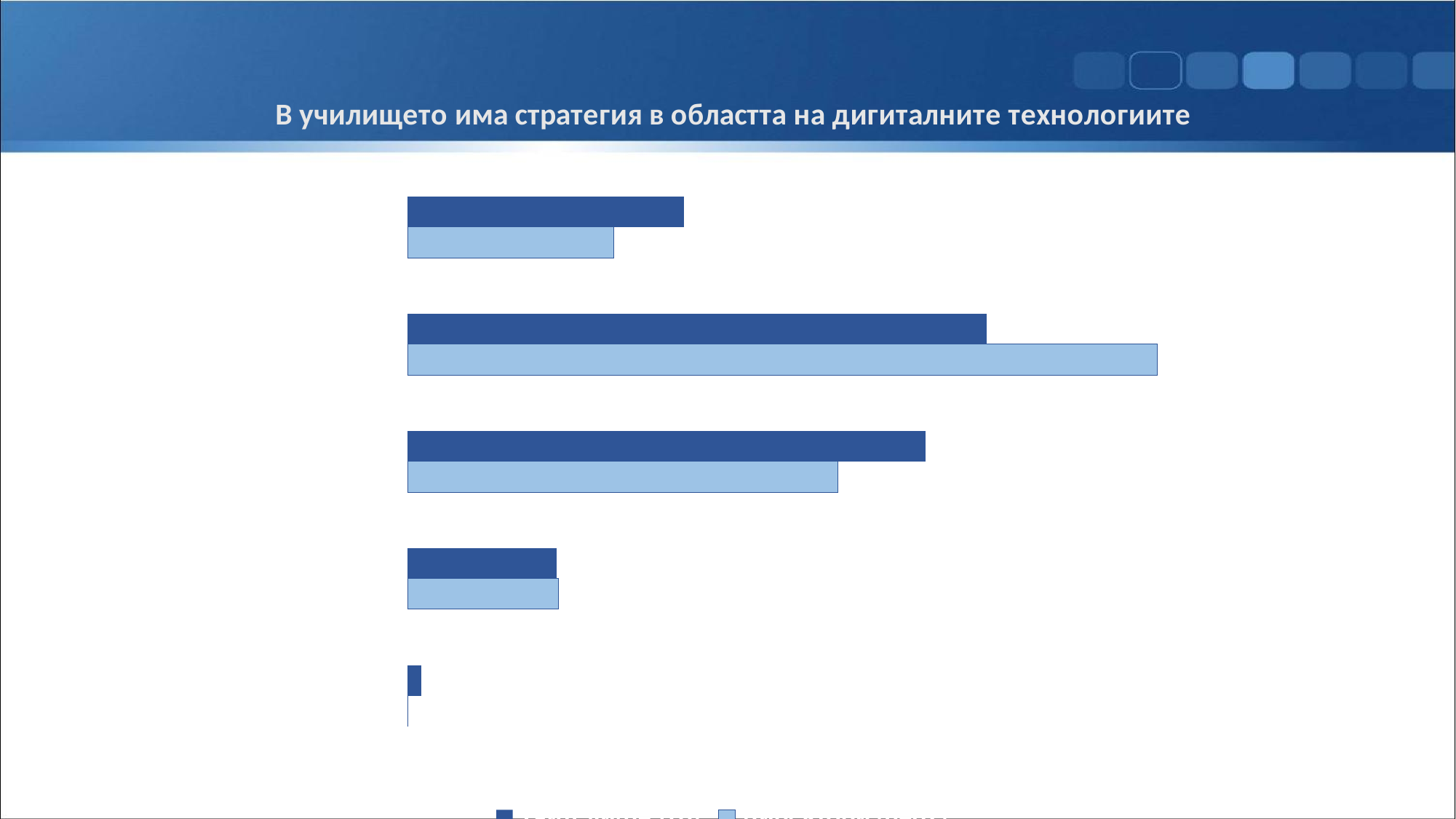
Which group of bars, counted from the top, contains the shortest bars in the chart? the fifth (bottom) group What is the title of the slide containing the chart? В училището има стратегия в областта на дигиталните технологиите How many groups of bars (categories) does the chart show? 5 What kind of chart is shown on the slide? bar chart In the first group of bars from the top, which bar is longer: the dark blue one or the light blue one? the dark blue one Which group of bars, counted from the top, contains the longest bar in the chart? the second group In the third group of bars from the top, which bar is longer: the dark blue one or the light blue one? the dark blue one In the second group of bars from the top, which bar is longer: the dark blue one or the light blue one? the light blue one How many series does the chart's legend list? 2 What two colours are used for the bars in the chart? dark blue and light blue